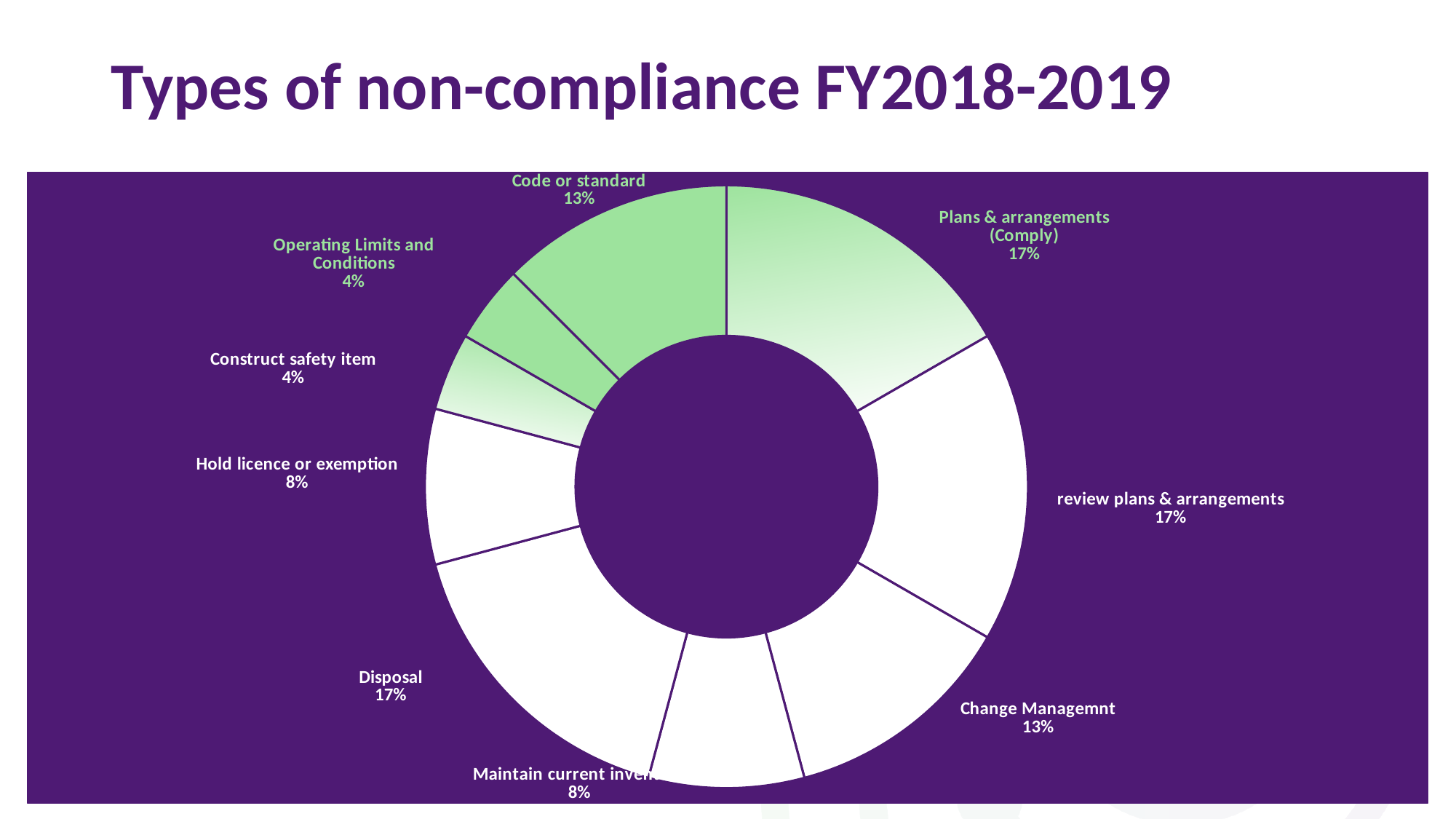
What is the value for Hold licence or exemption? 8% Which is larger, Code or standard or Construct safety item? Code or standard What percentage is shown for Construct safety item? 4% What share of the chart does Disposal represent? 17% What percentage of non-compliance is attributed to Change Managemnt? 13% What is the title of the chart? Types of non-compliance FY2018-2019 What is the value for Code or standard? 13% How many categories are shown in the chart? 9 Which is larger, review plans & arrangements or Hold licence or exemption? review plans & arrangements What is the difference between the Disposal share and the Operating Limits and Conditions share? 13% What type of chart is shown on the slide? Doughnut (pie) chart What percentage is shown for Plans & arrangements (Comply)? 17%